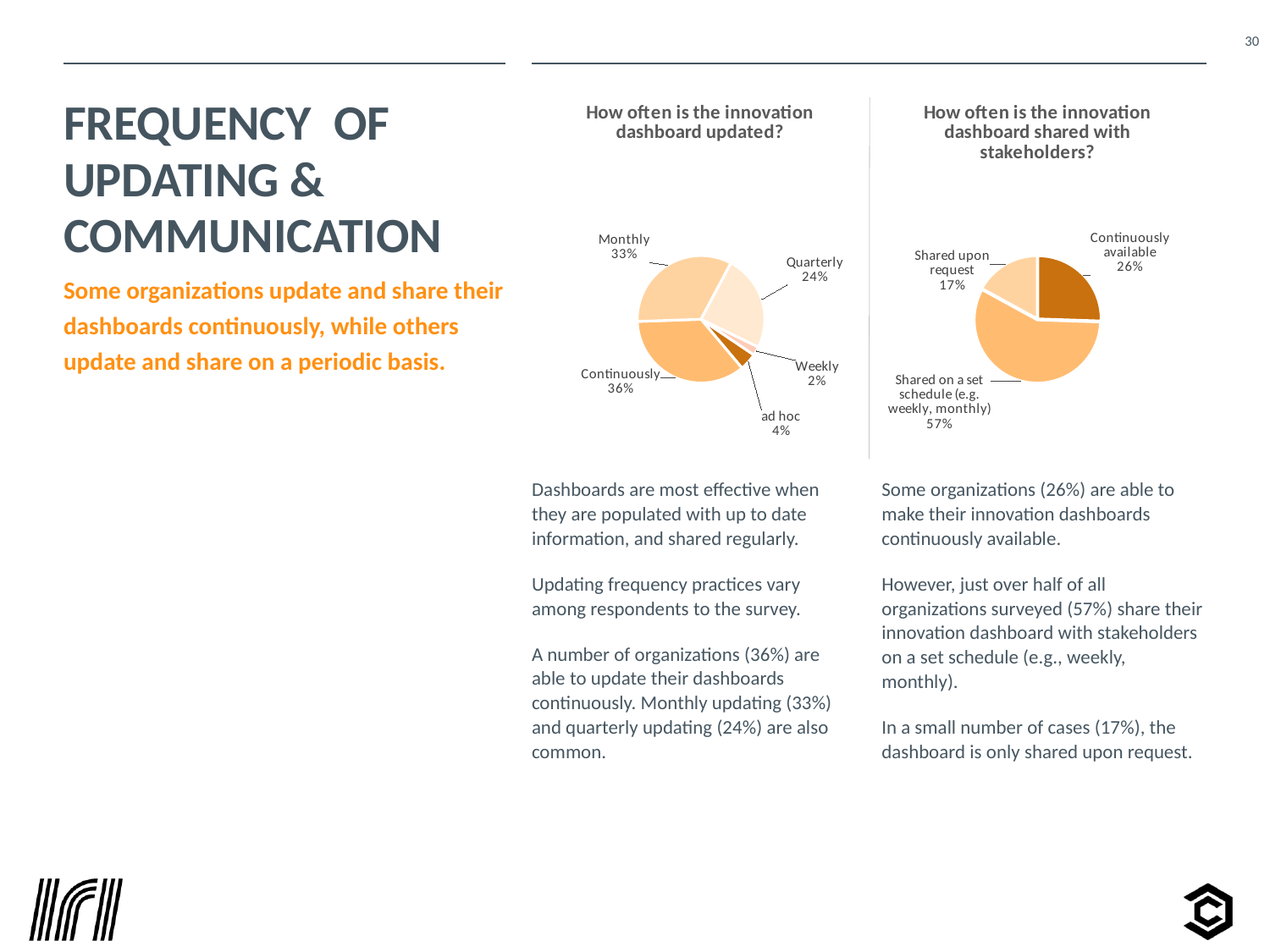
In the chart titled "How often is the innovation dashboard shared with stakeholders?", which is larger: Continuously available or Shared upon request? Continuously available In the chart titled "How often is the innovation dashboard shared with stakeholders?", what share is shared upon request? 17% What type of chart is used for "How often is the innovation dashboard updated?"? Pie chart In the chart titled "How often is the innovation dashboard shared with stakeholders?", what share is shared on a set schedule? 57% In the chart titled "How often is the innovation dashboard updated?", which category has the smallest share? Weekly In the chart titled "How often is the innovation dashboard updated?", what is the difference between the Monthly and Quarterly shares? 9% In the chart titled "How often is the innovation dashboard shared with stakeholders?", how many categories are shown? 3 In the chart titled "How often is the innovation dashboard updated?", how many categories are shown? 5 In the chart titled "How often is the innovation dashboard shared with stakeholders?", which category has the largest share? Shared on a set schedule (e.g. weekly, monthly) In the chart titled "How often is the innovation dashboard updated?", which category has the largest share? Continuously In the chart titled "How often is the innovation dashboard updated?", what share of respondents update monthly? 33% In the chart titled "How often is the innovation dashboard updated?", what share of respondents update continuously? 36%